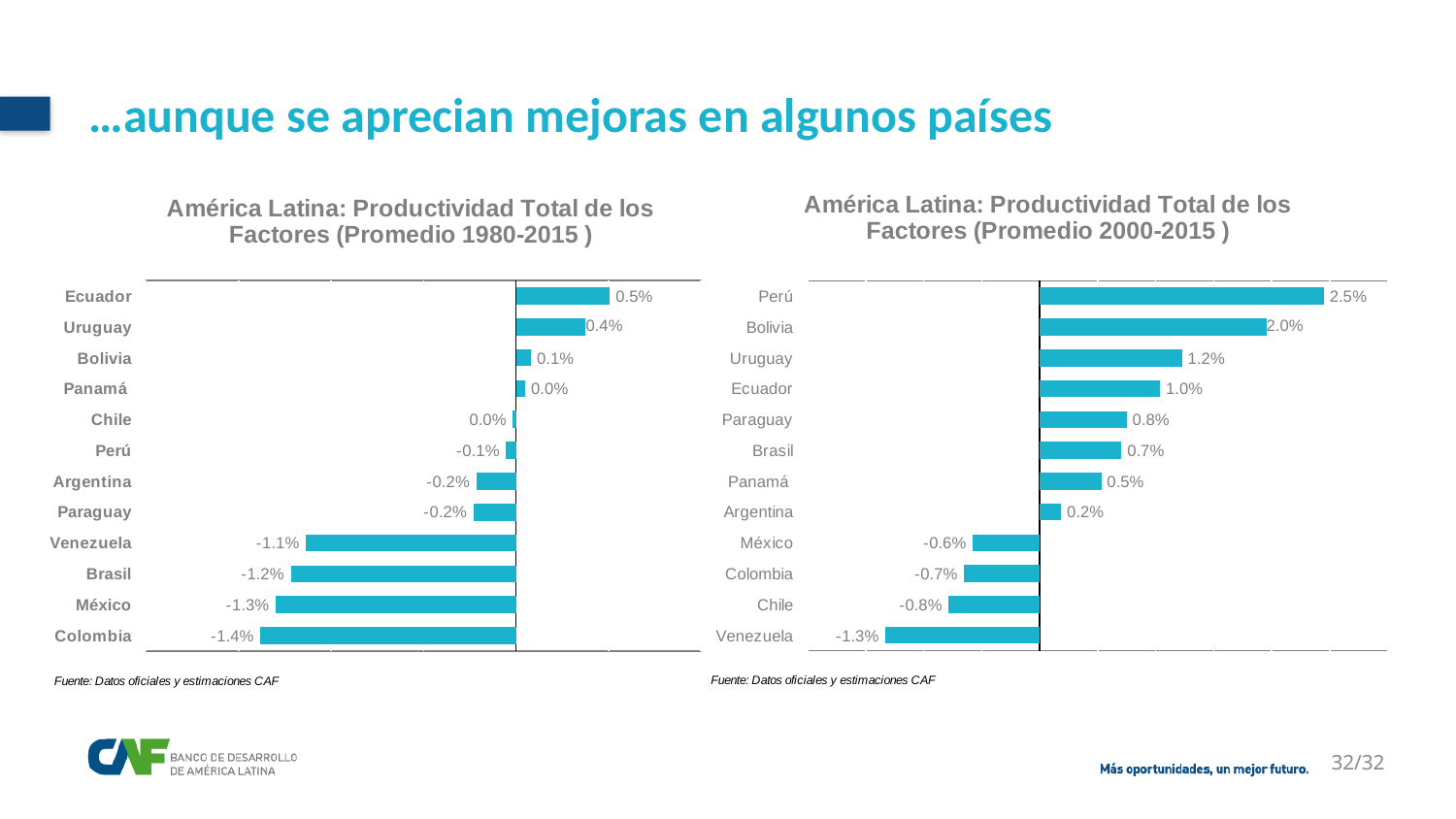
In the chart 'América Latina: Productividad Total de los Factores (Promedio 2000-2015)', which country has the lowest value? Venezuela In the chart 'América Latina: Productividad Total de los Factores (Promedio 2000-2015)', which country has the highest value? Perú What type of chart is the chart on the right side of the slide? Bar chart In the chart 'América Latina: Productividad Total de los Factores (Promedio 2000-2015)', what is the difference between the values for Perú and Uruguay? 1.3% In the chart 'América Latina: Productividad Total de los Factores (Promedio 1980-2015)', which country has the lowest value? Colombia In the chart 'América Latina: Productividad Total de los Factores (Promedio 2000-2015)', which is larger, the value for Paraguay or the value for Panamá? Paraguay In the chart 'América Latina: Productividad Total de los Factores (Promedio 2000-2015)', what is the value for Venezuela? -1.3% In the chart 'América Latina: Productividad Total de los Factores (Promedio 2000-2015)', what is the value for Bolivia? 2.0% In the chart 'América Latina: Productividad Total de los Factores (Promedio 1980-2015)', what is the difference between the values for Uruguay and Brasil? 1.6% In the chart 'América Latina: Productividad Total de los Factores (Promedio 1980-2015)', how many countries are shown? 12 In the chart 'América Latina: Productividad Total de los Factores (Promedio 1980-2015)', what is the value for Ecuador? 0.5% In the chart 'América Latina: Productividad Total de los Factores (Promedio 1980-2015)', what is the value for Venezuela? -1.1%